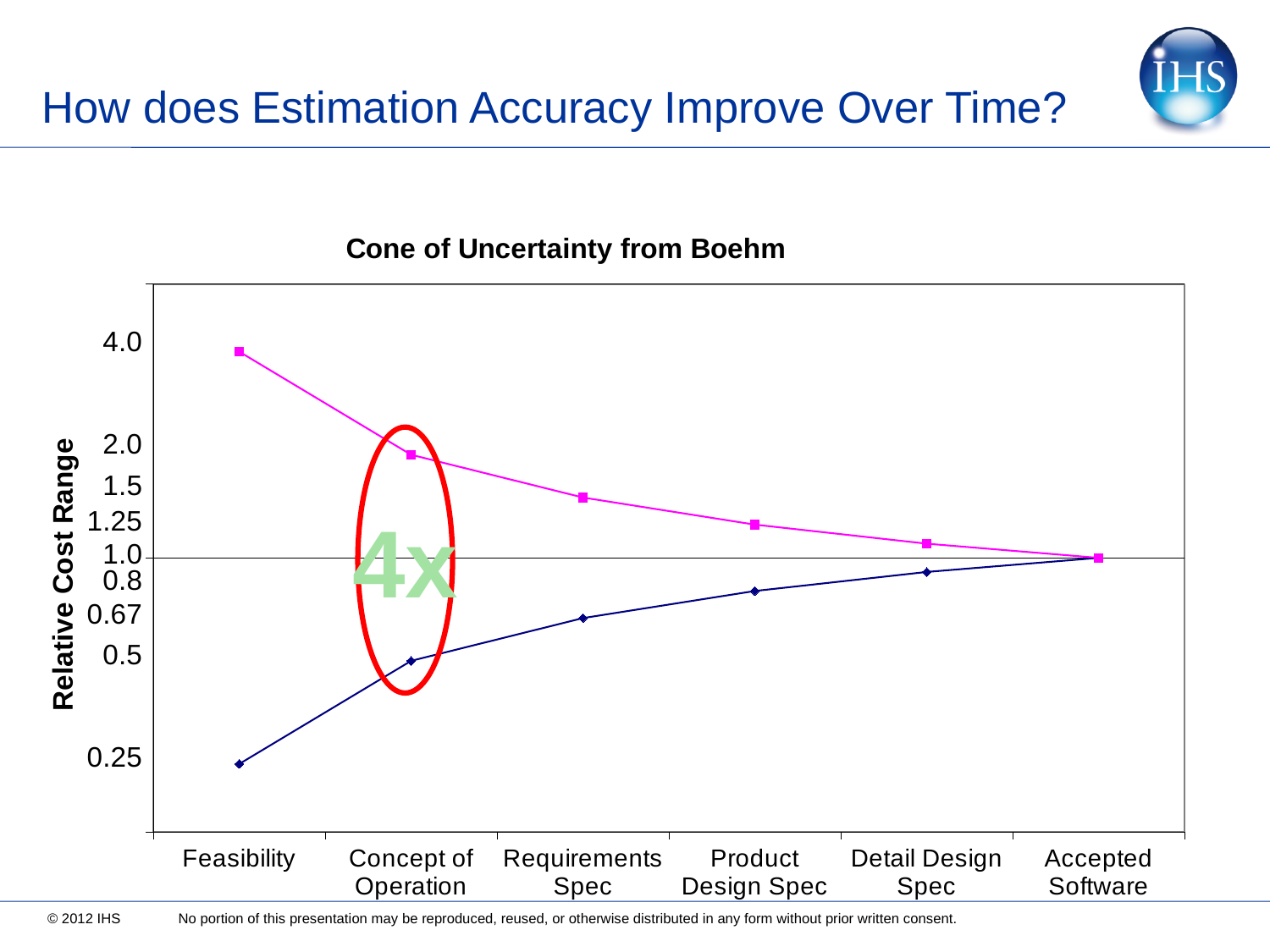
What is the label of the y axis? Relative Cost Range Is the value of the upper (pink) line at Requirements Spec greater or less than 1.25? greater Does the lower (dark blue) line rise or fall from Feasibility to Accepted Software? rise Does the upper (pink) line rise or fall from Feasibility to Accepted Software? fall How many categories are shown on the x axis of the chart? 6 Is the value of the lower (dark blue) line at Product Design Spec greater or less than 1.0? less How many lines are plotted on the chart? 2 At which category is the upper (pink) line highest? Feasibility What type of chart is shown on the slide? line chart What value do both lines reach at Accepted Software? 1.0 At which category is the lower (dark blue) line lowest? Feasibility What is the title of the chart? Cone of Uncertainty from Boehm